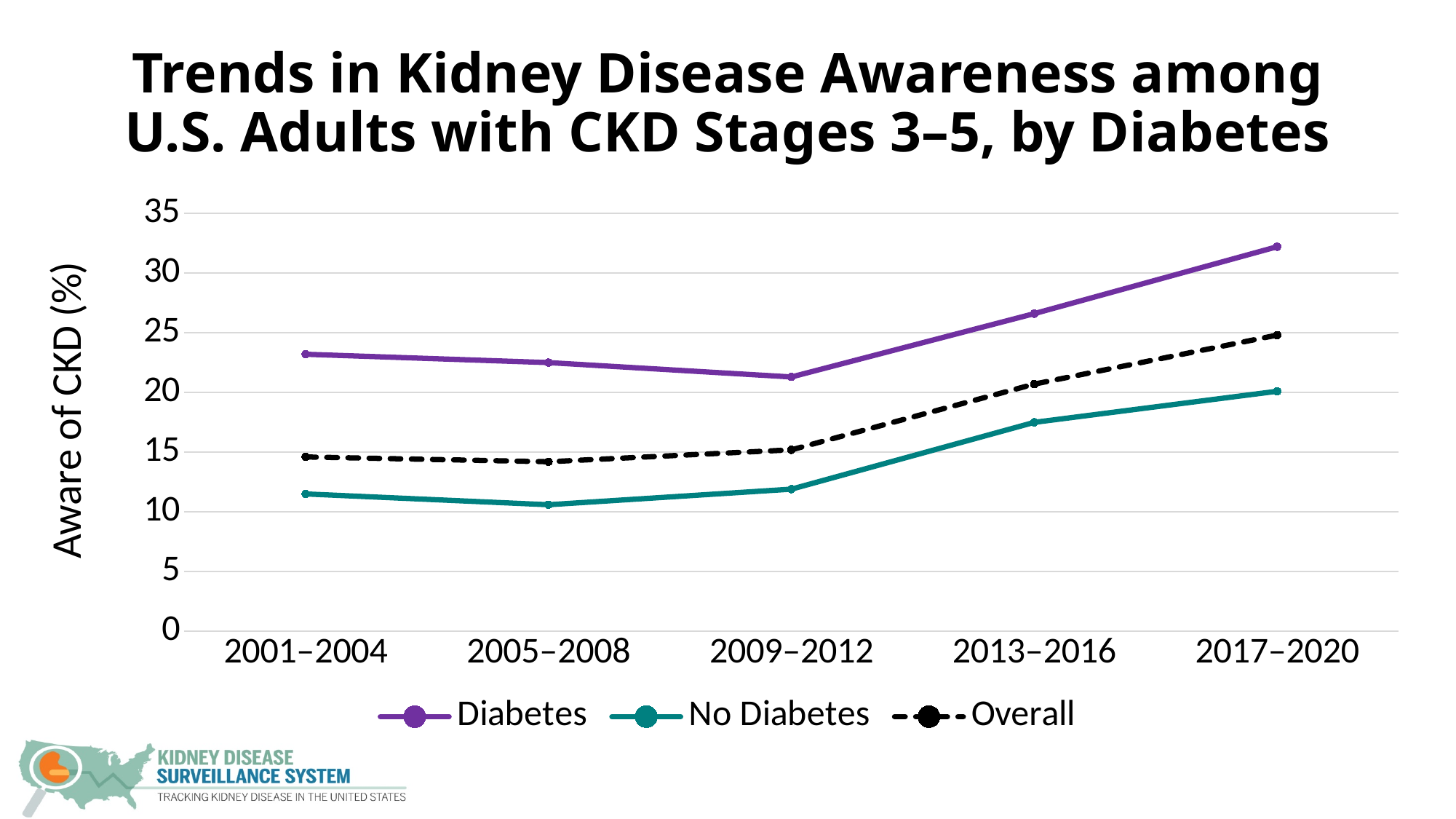
Which series is drawn with a dashed line? Overall In which period is the Diabetes series at its lowest? 2009–2012 Is the value for Diabetes in 2017–2020 greater or less than 30? greater Is the value for Overall in 2017–2020 greater or less than 20? greater How many series does the legend list? 3 What kind of chart is shown on the slide? line chart Is the value for Diabetes in 2009–2012 greater or less than 25? less Does the Overall series rise or fall from 2009–2012 to 2017–2020? rise Which series has the higher value in 2017–2020, Diabetes or No Diabetes? Diabetes How many time periods are shown on the x axis? 5 In which period is the Diabetes series at its highest? 2017–2020